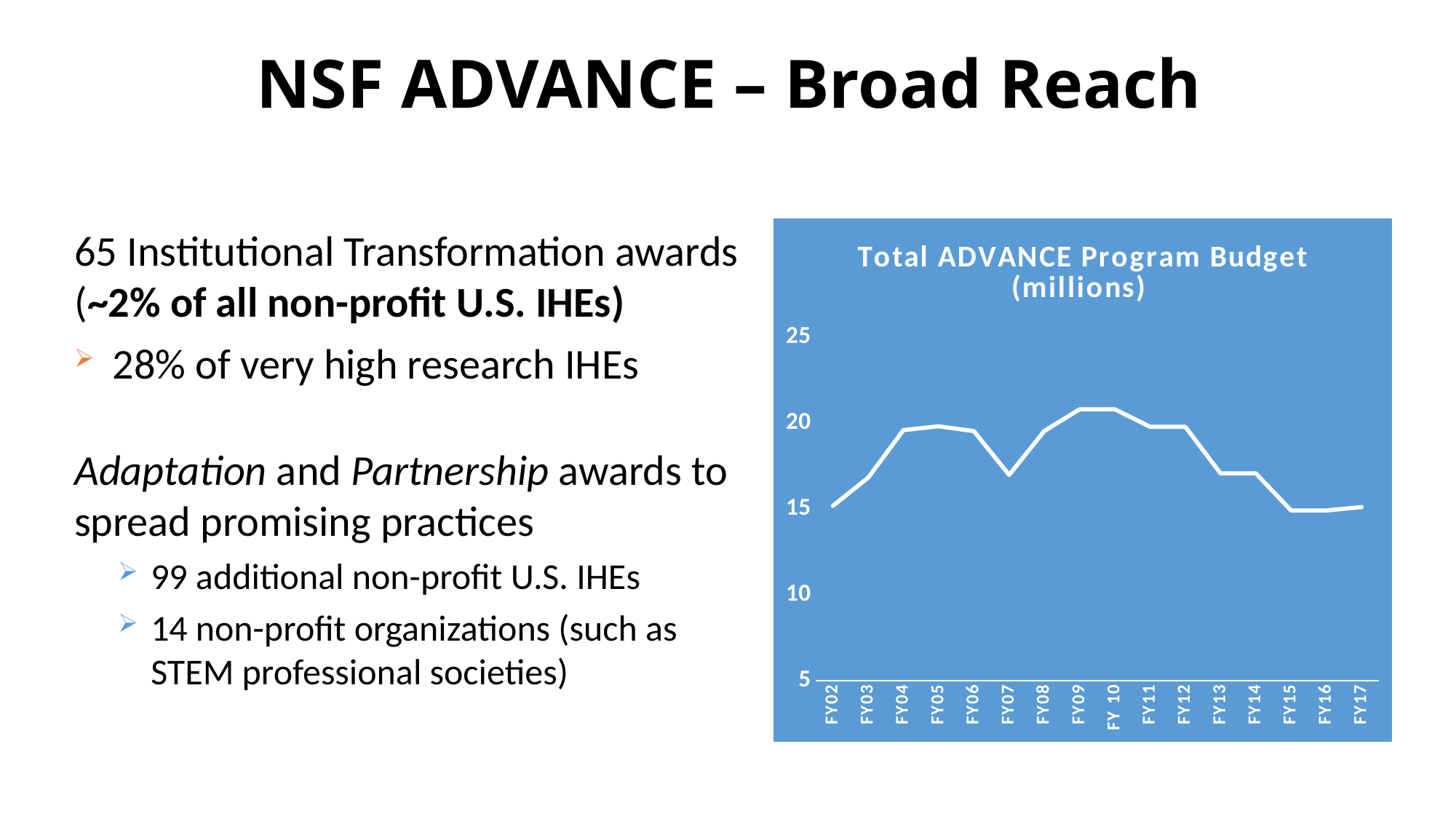
Do the values rise or fall from FY12 to FY15? fall Is the value for FY07 greater or less than 15? greater Do the values rise or fall from FY02 to FY05? rise What kind of chart is shown on the slide? line chart How many fiscal years are plotted on the x axis of the chart? 16 What is the title of the chart? Total ADVANCE Program Budget (millions) Is the value for FY07 greater or less than 20? less Which is larger, the value for FY04 or the value for FY07? FY04 Is the value for FY13 greater or less than 15? greater Which is larger, the value for FY09 or the value for FY15? FY09